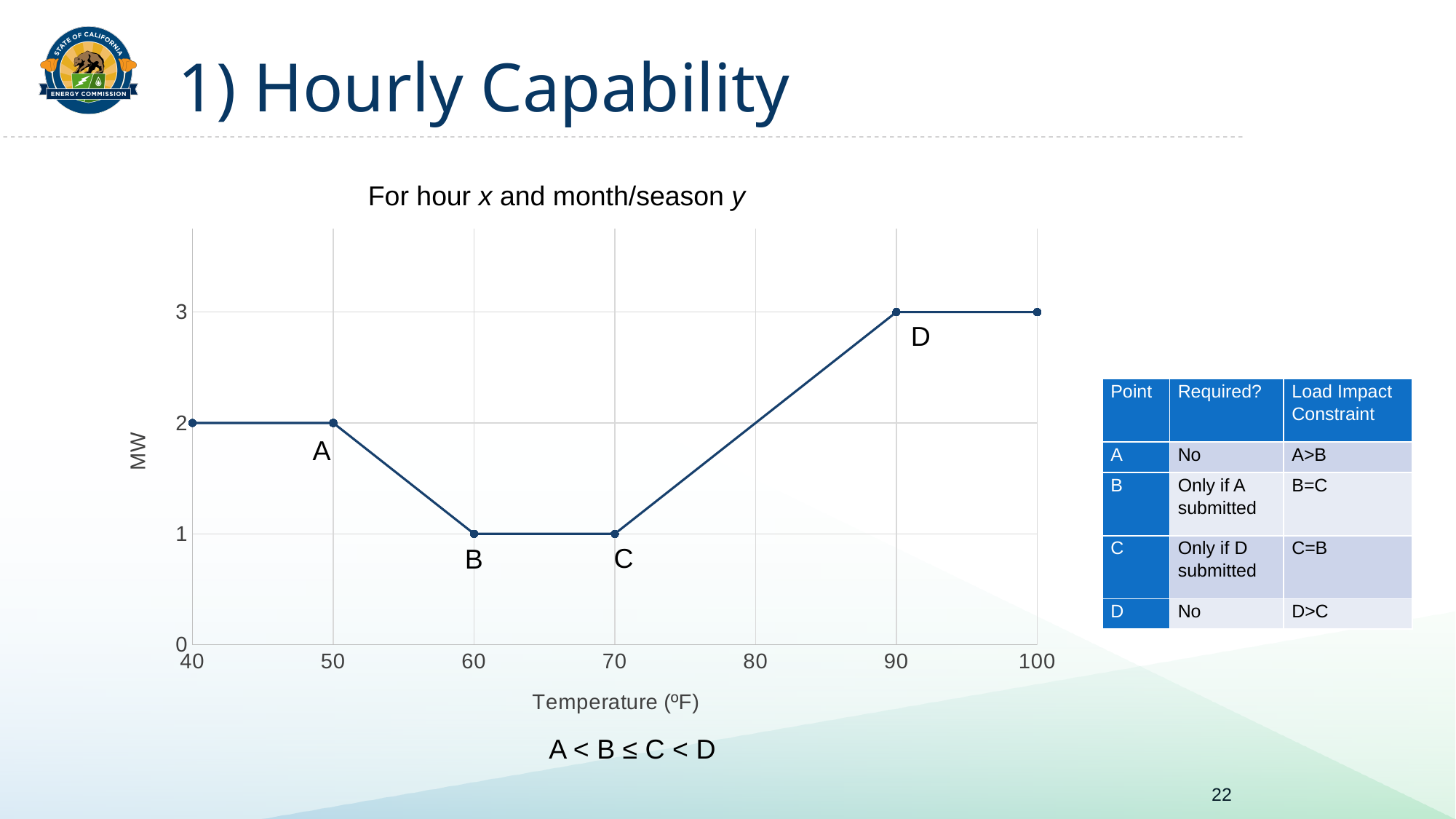
Does the line rise or fall between 50ºF and 60ºF? fall What is the MW value at point B? 1 Which labeled point has the highest MW value? D At what temperature (ºF) is point B located? 60 At what temperature (ºF) is point D located? 90 What is the MW value at point A? 2 What is the label of the x axis? Temperature (ºF) What is the MW value at point D? 3 What type of chart is shown on the slide? line chart How many plotted data points are on the line? 6 Which has a larger MW value, point A or point C? A What is the difference in MW between point D and point A? 1